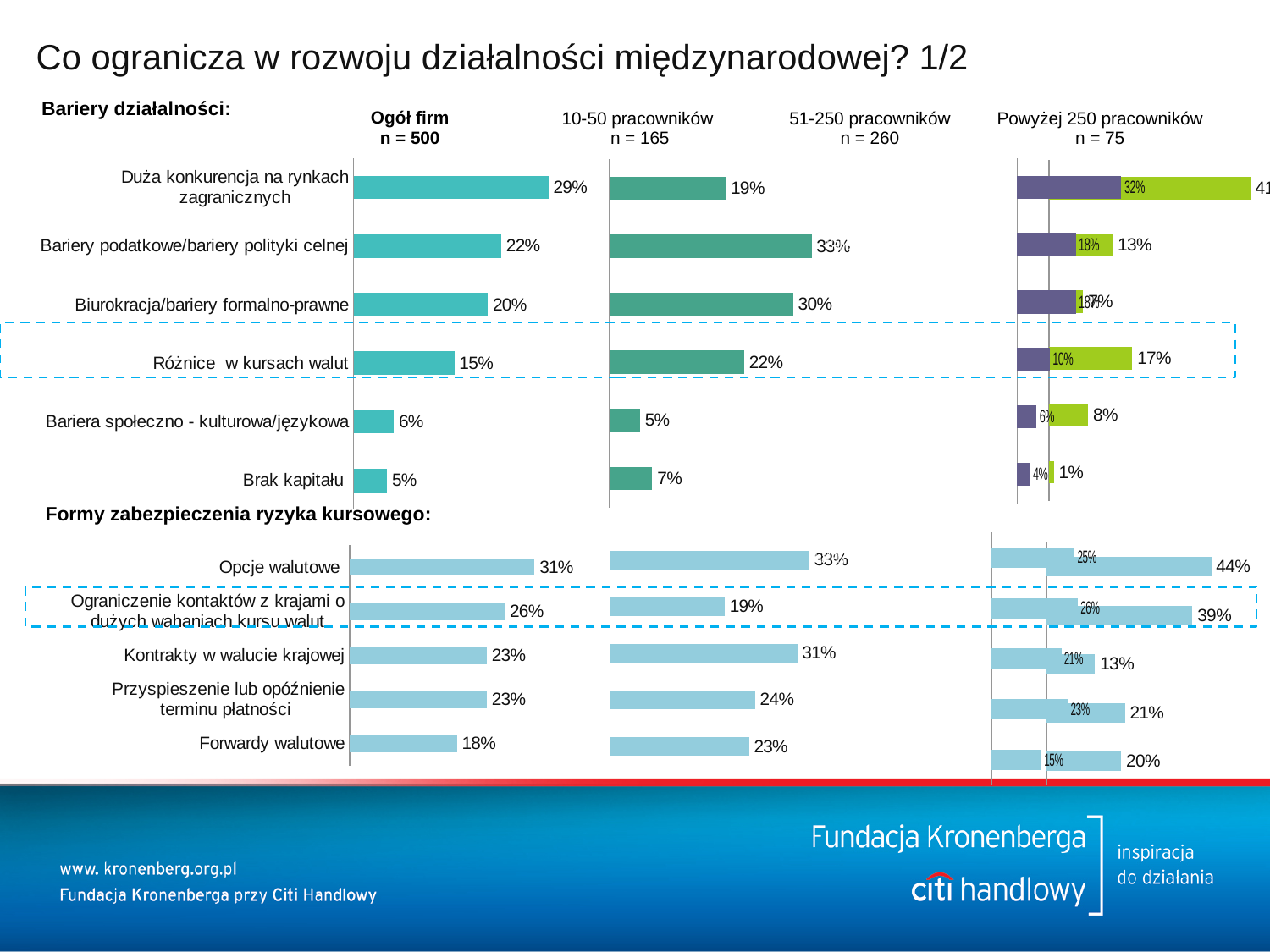
In the 'Bariery działalności' section, in the 'Ogół firm' chart, which category has the highest value? Duża konkurencja na rynkach zagranicznych In the 'Bariery działalności' section, in the 'Ogół firm' chart, what is the difference between 'Bariery podatkowe/bariery polityki celnej' and 'Różnice w kursach walut'? 7 percentage points In the 'Bariery działalności' section, in the second chart from the left, which category has the highest value? Bariery podatkowe/bariery polityki celnej How many categories are shown in the 'Formy zabezpieczenia ryzyka kursowego' section of the 'Ogół firm' chart? 5 In the 'Formy zabezpieczenia ryzyka kursowego' section, in the second chart from the left, what is the value for 'Kontrakty w walucie krajowej'? 31% In the 'Formy zabezpieczenia ryzyka kursowego' section, in the 'Ogół firm' chart, which is larger: 'Kontrakty w walucie krajowej' or 'Forwardy walutowe'? Kontrakty w walucie krajowej How many categories are shown in the 'Bariery działalności' section of the 'Ogół firm' chart? 6 What type of chart is used for the 'Ogół firm' data on this slide? Bar chart In the 'Formy zabezpieczenia ryzyka kursowego' section, in the 'Ogół firm' chart, what is the value for 'Opcje walutowe'? 31% In the 'Bariery działalności' section, in the second chart from the left, what is the value for 'Biurokracja/bariery formalno-prawne'? 30% In the 'Bariery działalności' section, in the 'Ogół firm' chart, which category has the lowest value? Brak kapitału In the 'Bariery działalności' section, in the 'Ogół firm' chart, what is the value for 'Duża konkurencja na rynkach zagranicznych'? 29%